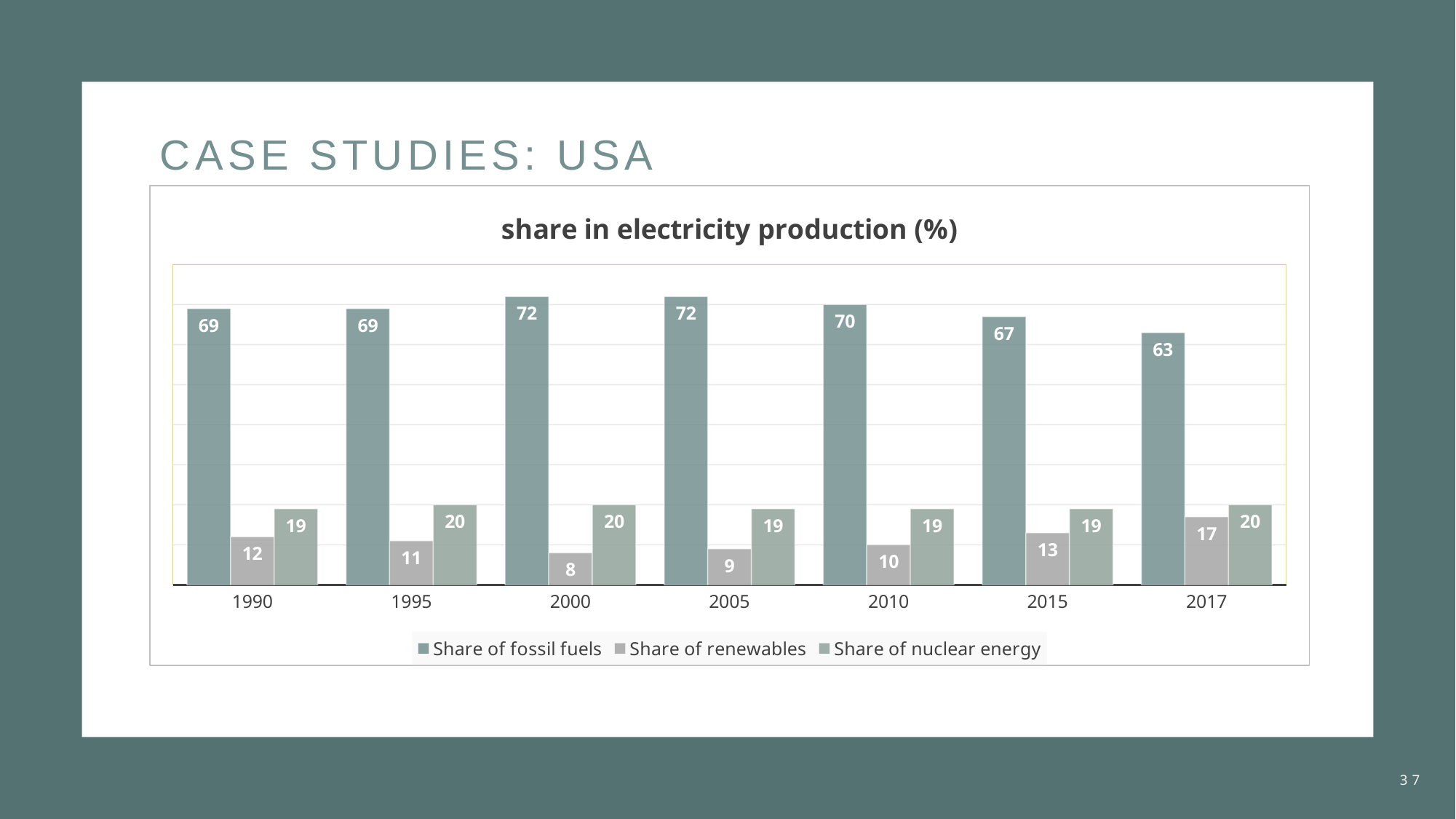
What is the share of nuclear energy in 1995? 20 What kind of chart is shown on the slide? Bar chart What is the difference between the share of fossil fuels in 2005 and in 2017? 9 What is the title of the chart? share in electricity production (%) What is the share of fossil fuels in 2000? 72 What is the share of renewables in 2017? 17 How many series does the legend list? 3 Which is larger in 2010: the share of renewables or the share of nuclear energy? Share of nuclear energy How many years are shown on the x axis? 7 In which year is the share of fossil fuels lowest? 2017 In which year is the share of renewables lowest? 2000 What is the difference between the share of nuclear energy and the share of renewables in 1990? 7